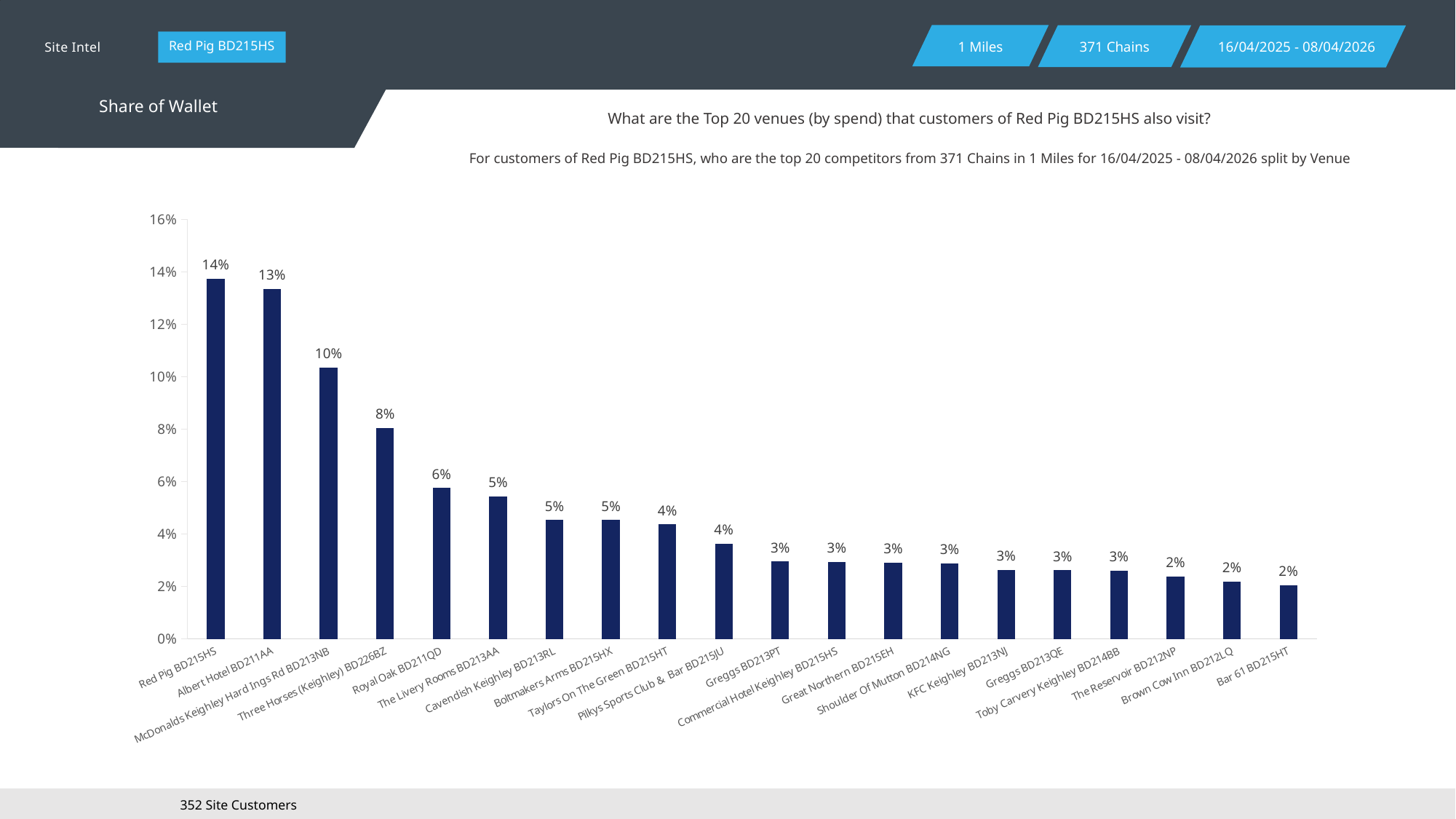
What is the value for Three Horses (Keighley) BD226BZ? 8% Is the value for Albert Hotel BD211AA greater or less than 12%? greater How many venues are shown on the chart? 20 What is the difference between the values for Red Pig BD215HS and McDonalds Keighley Hard Ings Rd BD213NB? 4% What is the value for Bar 61 BD215HT? 2% What is the value for Royal Oak BD211QD? 6% What kind of chart is shown? bar chart What is the value for Red Pig BD215HS? 14% Which is larger, the value for Three Horses (Keighley) BD226BZ or Royal Oak BD211QD? Three Horses (Keighley) BD226BZ What is the value for McDonalds Keighley Hard Ings Rd BD213NB? 10% Do the values rise or fall from left to right along the x axis? fall Which venue has the highest value? Red Pig BD215HS